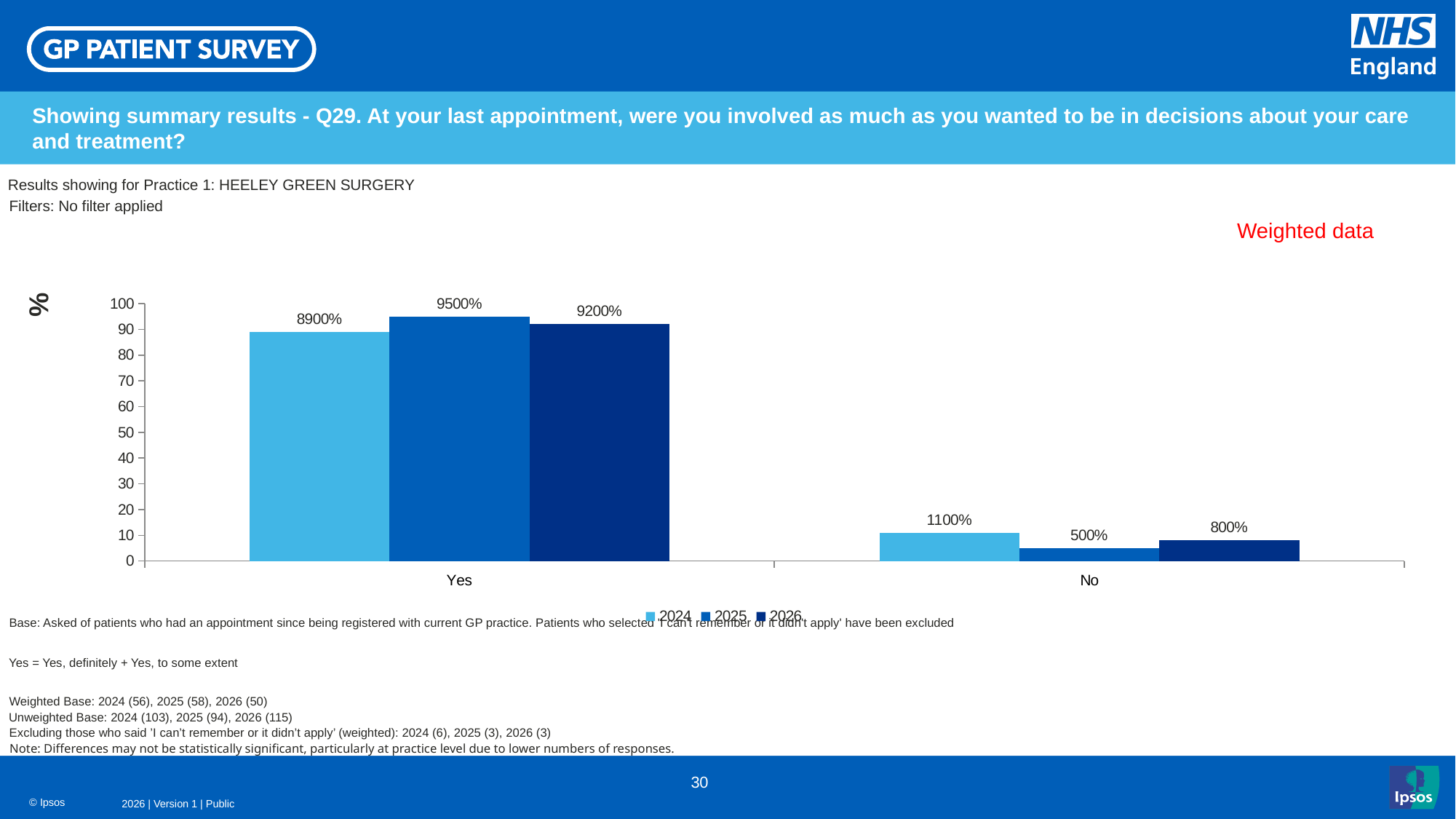
Is the 2026 bar in the No category greater or less than 10 on the axis? less What is the data label shown for 2024 in the No category? 1100% How many series does the legend list? 3 Which year has the lowest bar in the No category? 2025 Which is larger in the Yes category, the 2024 bar or the 2026 bar? 2026 What is the data label shown for 2025 in the Yes category? 9500% What is the data label shown for 2025 in the No category? 500% Which practice are the results shown for? Practice 1: HEELEY GREEN SURGERY What is the data label shown for 2026 in the Yes category? 9200% What kind of chart is shown on the slide? Bar chart How many categories are shown on the x axis? 2 Which year has the highest bar in the Yes category? 2025